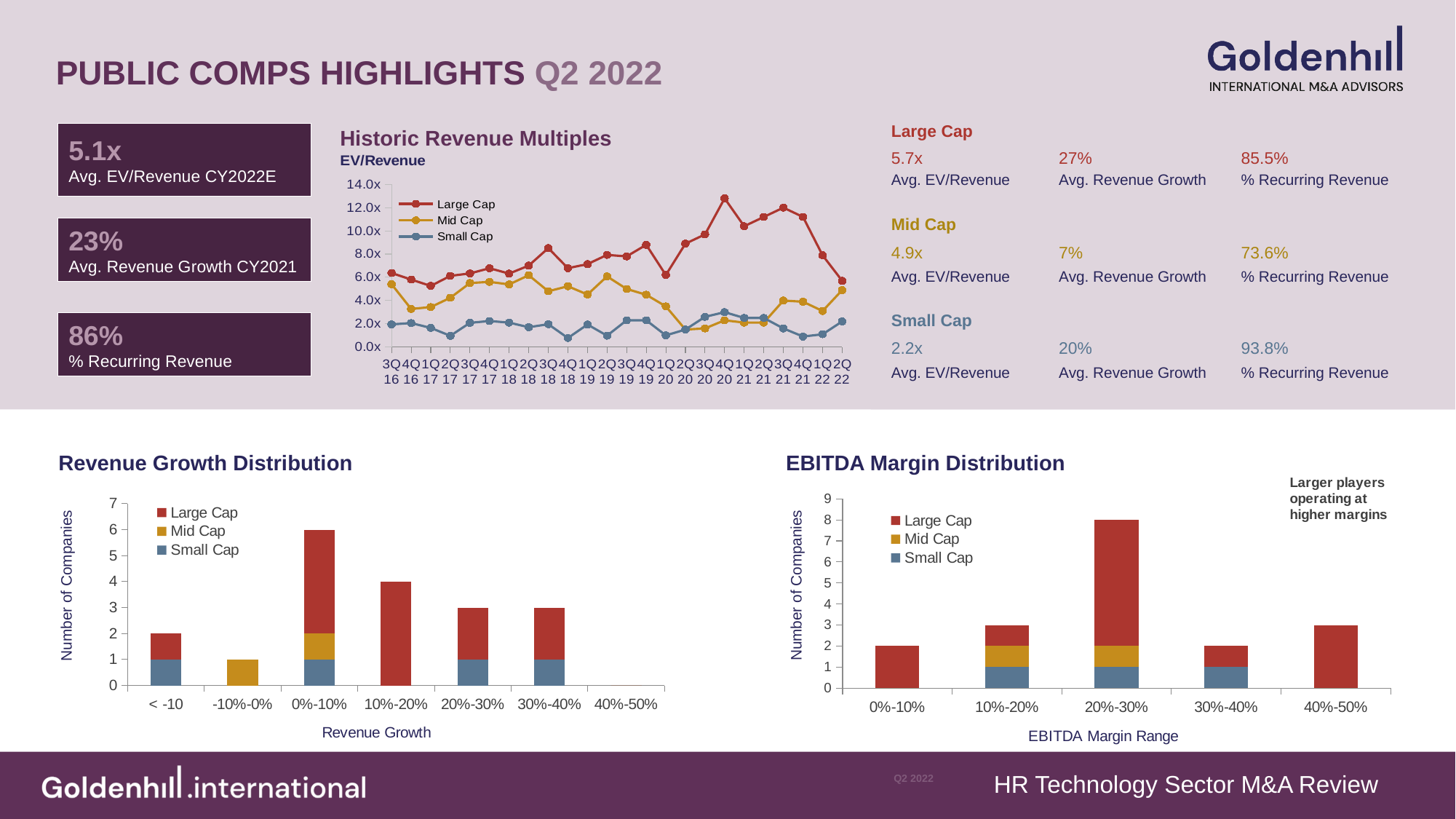
What kind of chart is the Historic Revenue Multiples chart? line chart In the EBITDA Margin Distribution chart, which EBITDA margin range has the tallest bar? 20%-30% In the Historic Revenue Multiples chart, which series has the highest value at 4Q20? Large Cap How many revenue growth categories are shown on the x axis of the Revenue Growth Distribution chart? 7 In the EBITDA Margin Distribution chart, how many Small Cap companies are in the 30%-40% range? 1 In the EBITDA Margin Distribution chart, what is the total number of companies in the 20%-30% bar? 8 In the Revenue Growth Distribution chart, which revenue growth range has the tallest bar? 0%-10% How many series does the legend of the Historic Revenue Multiples chart list? 3 What kind of chart is the Revenue Growth Distribution chart? bar chart In the Historic Revenue Multiples chart, is the Small Cap value at 4Q20 greater or less than 4.0x? less In the Historic Revenue Multiples chart, is the Large Cap value at 4Q20 greater or less than 12.0x? greater In the Revenue Growth Distribution chart, what is the total number of companies in the 0%-10% bar? 6